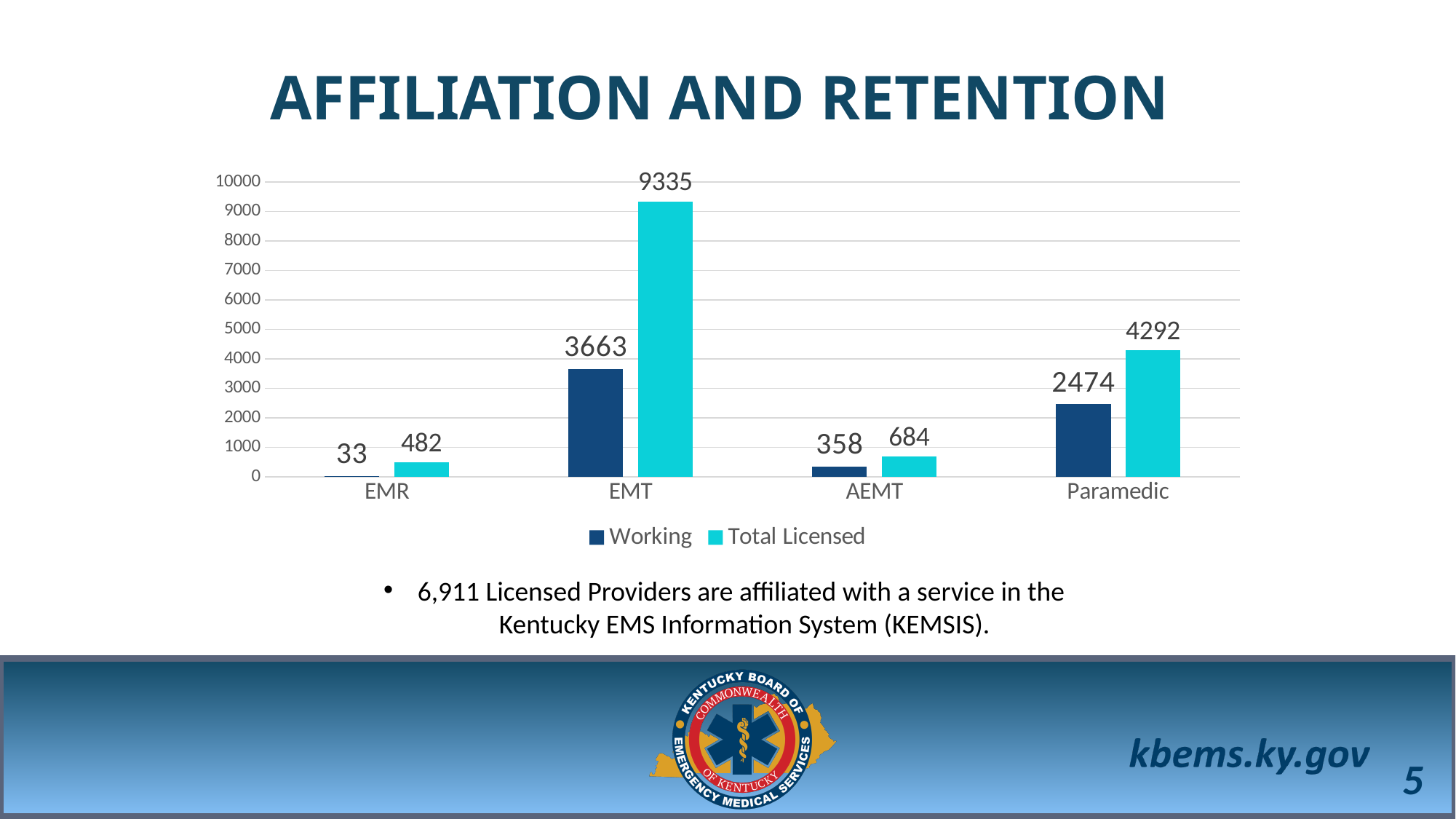
What kind of chart is shown on the slide? Bar chart What is the Total Licensed value for AEMT? 684 What is the Total Licensed value for Paramedic? 4292 What is the Working value for EMR? 33 What is the difference between Total Licensed and Working for Paramedic? 1818 Which category has the lowest Working value? EMR How many categories are shown on the x axis? 4 What is the difference between Total Licensed and Working for EMT? 5672 How many series does the legend list? 2 Which category has the highest Total Licensed value? EMT What is the Working value for EMT? 3663 Which is larger, the Working value for AEMT or the Working value for Paramedic? Paramedic